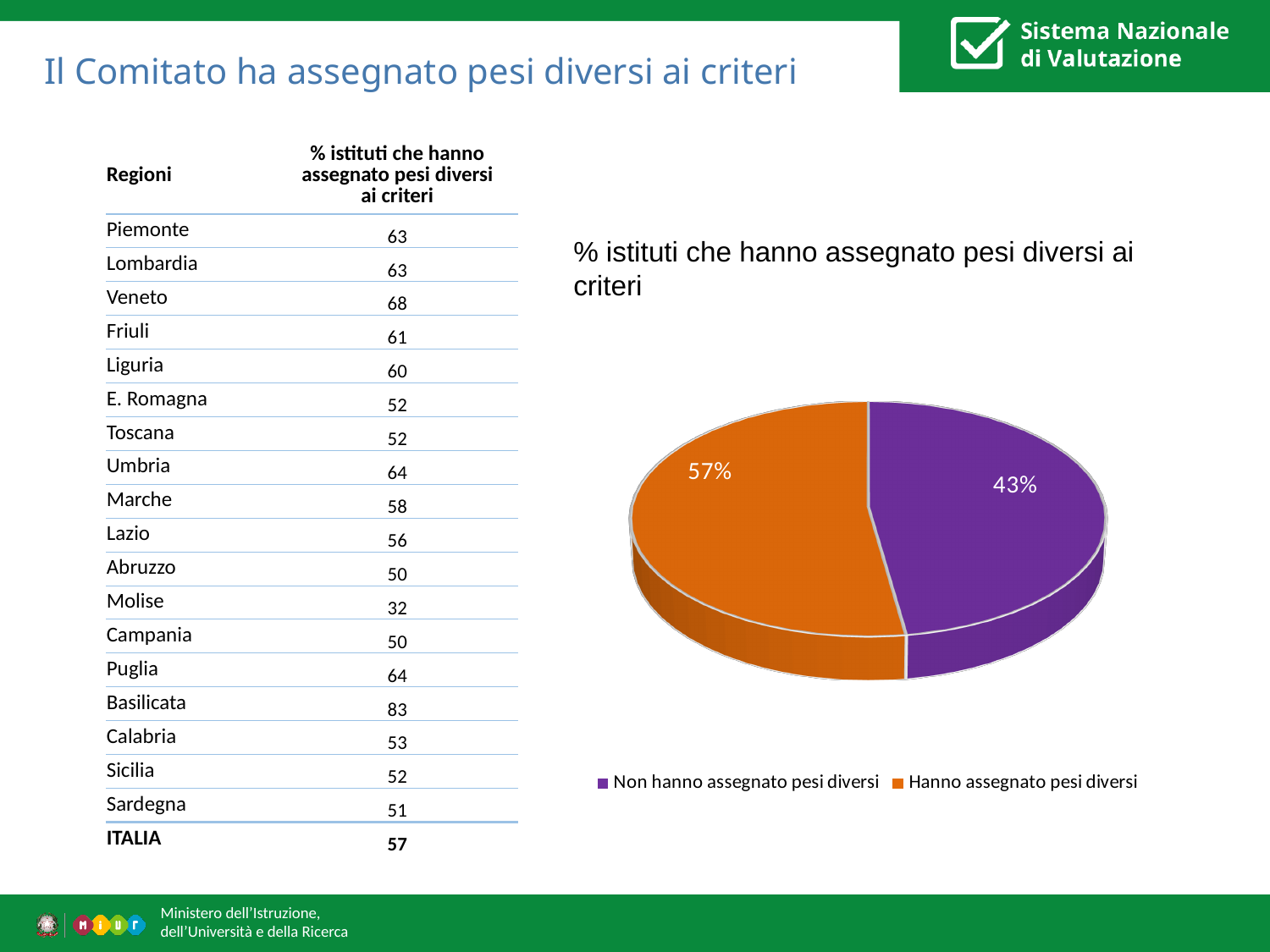
What is the value for "Non hanno assegnato pesi diversi" in the pie chart? 43% How many entries does the pie chart legend list? 2 What is the difference between the "Hanno assegnato pesi diversi" and "Non hanno assegnato pesi diversi" slices? 14% What share of the pie does the orange slice represent? 57% Which slice of the pie chart is the smallest? Non hanno assegnato pesi diversi What is the value for "Hanno assegnato pesi diversi" in the pie chart? 57% What is the title of the pie chart? % istituti che hanno assegnato pesi diversi ai criteri What kind of chart is shown on the slide? pie chart How many slices does the pie chart have? 2 Which slice of the pie chart is the largest? Hanno assegnato pesi diversi What colour is the "Non hanno assegnato pesi diversi" slice in the pie chart? purple Which is larger in the pie chart: "Hanno assegnato pesi diversi" or "Non hanno assegnato pesi diversi"? Hanno assegnato pesi diversi